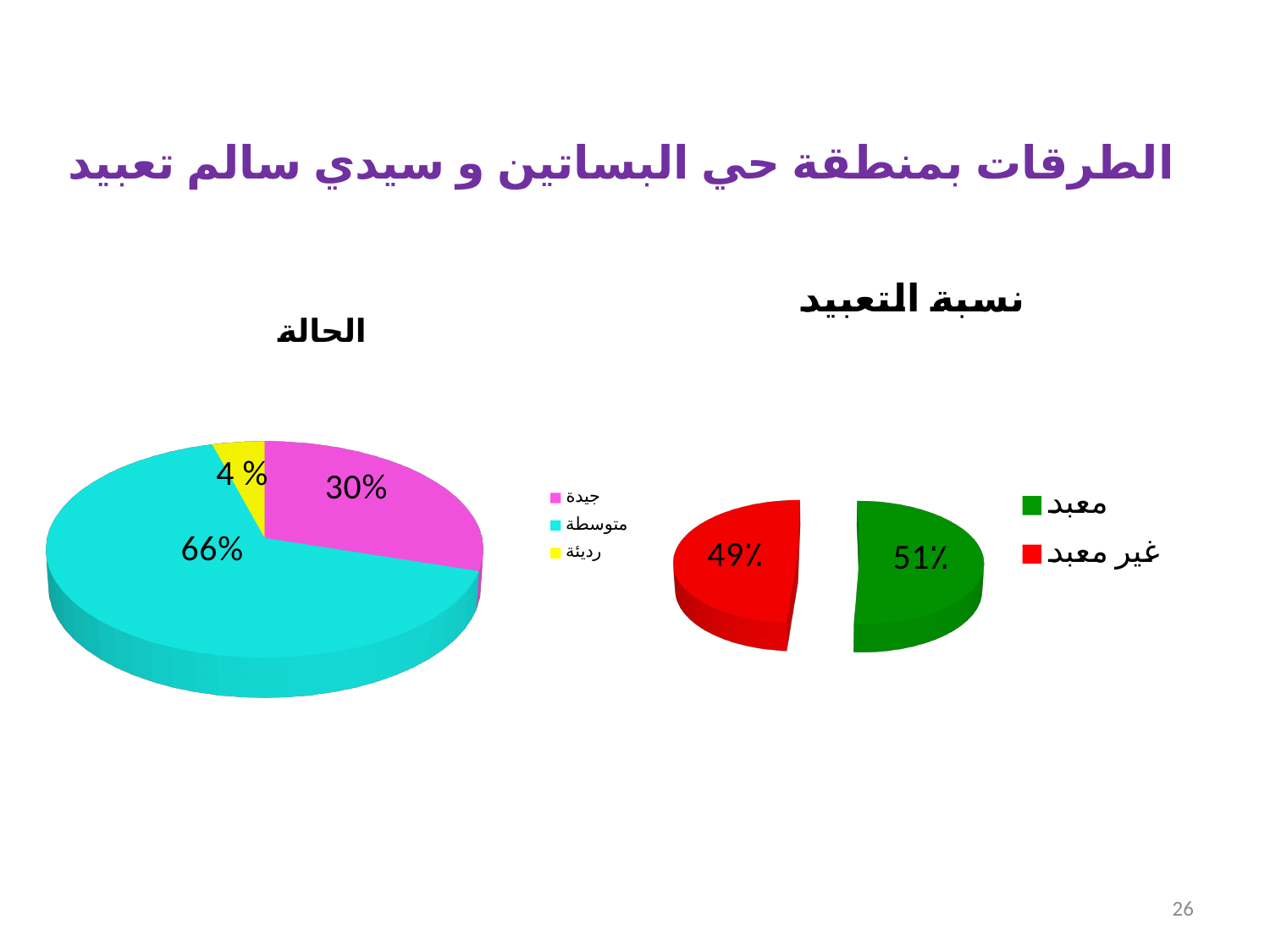
In the chart titled "الحالة", what is the difference in percentage points between "متوسطة" and "جيدة"? 36 In the chart titled "نسبة التعبيد", what is the difference in percentage points between "معبد" and "غير معبد"? 2 In the chart titled "الحالة", which category has the smallest slice? رديئة In the chart titled "الحالة", what percentage is shown for "رديئة"? 4 % In the chart titled "نسبة التعبيد", what percentage is shown for "معبد"? 51% What type of chart is the chart titled "نسبة التعبيد"? Pie chart In the chart titled "نسبة التعبيد", what percentage is shown for "غير معبد"? 49% In the chart titled "الحالة", how many categories does the legend list? 3 In the chart titled "الحالة", what percentage is shown for "جيدة"? 30% In the chart titled "الحالة", what percentage is shown for "متوسطة"? 66% In the chart titled "الحالة", which category has the largest slice? متوسطة In the chart titled "نسبة التعبيد", what colour is the "غير معبد" slice? Red